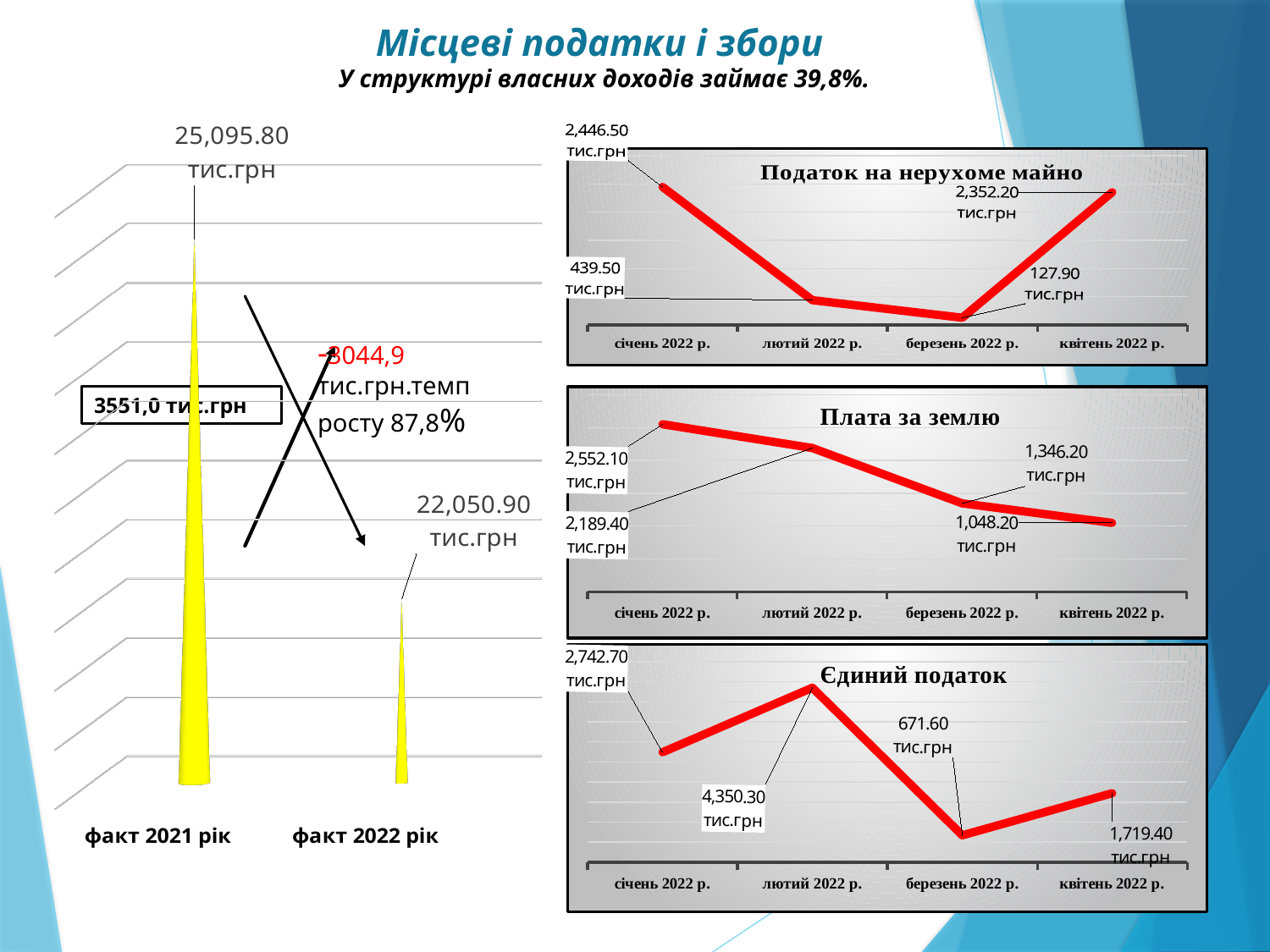
In the left chart, what is the value for факт 2022 рік? 22,050.90 тис.грн What kind of chart is 'Плата за землю'? line chart In the chart 'Податок на нерухоме майно', which month has the lowest value? березень 2022 р. In the chart 'Єдиний податок', which month has the highest value? лютий 2022 р. In the chart 'Плата за землю', what is the value for квітень 2022 р.? 1,048.20 тис.грн In the chart 'Податок на нерухоме майно', what is the value for січень 2022 р.? 2,446.50 тис.грн In the left chart, which is larger, факт 2021 рік or факт 2022 рік? факт 2021 рік In the left chart, what is the value for факт 2021 рік? 25,095.80 тис.грн In the left chart, what is the difference between факт 2021 рік and факт 2022 рік? 3,044.90 тис.грн How many data points are plotted in the chart 'Єдиний податок'? 4 In the chart 'Плата за землю', do the values rise or fall from січень to квітень 2022 р.? fall In the chart 'Єдиний податок', what is the value for березень 2022 р.? 671.60 тис.грн